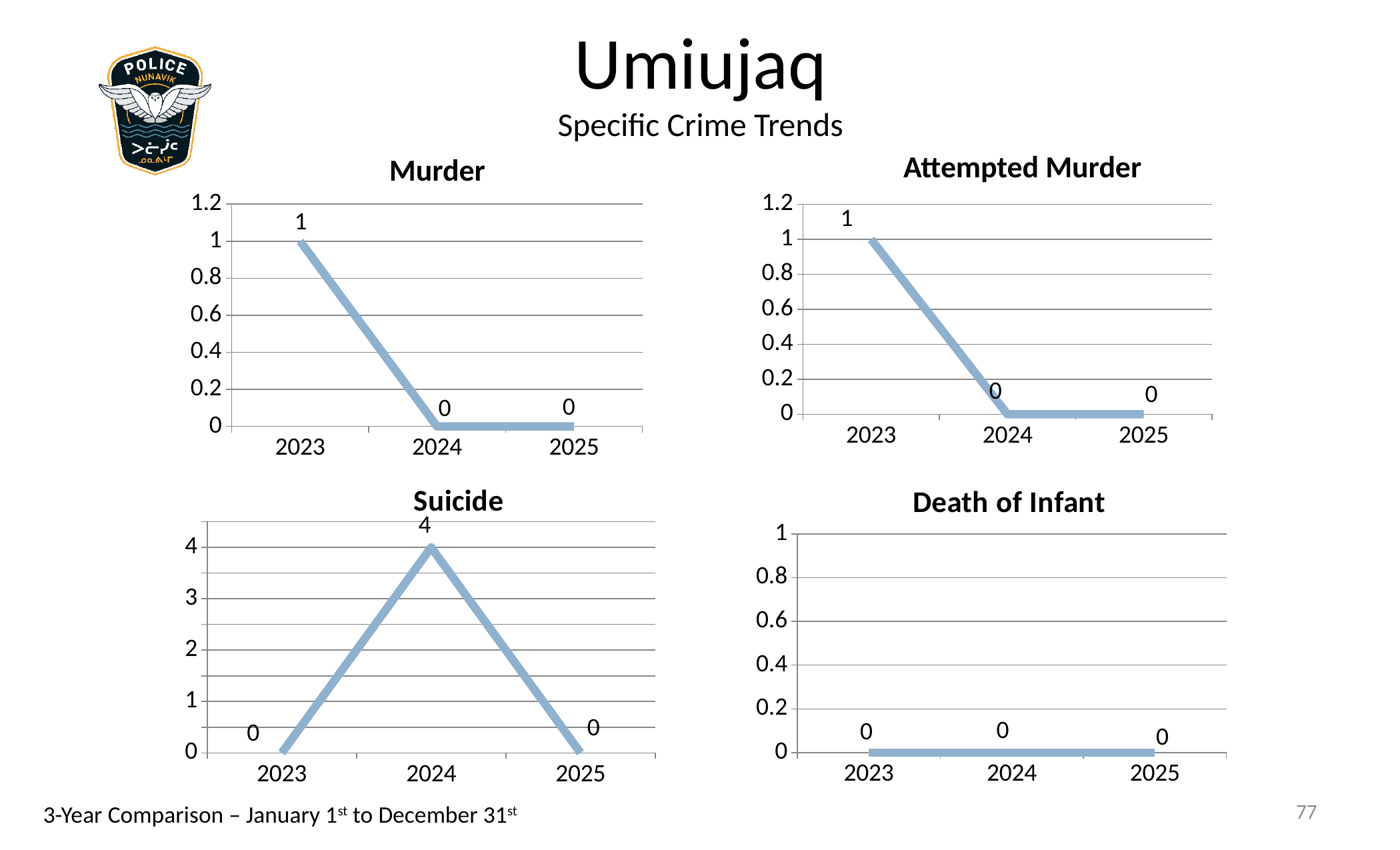
In the Murder chart, do the values rise or fall from 2023 to 2024? fall How many years are plotted in the Attempted Murder chart? 3 In the Death of Infant chart, what is the value for 2025? 0 In the Suicide chart, what is the value for 2024? 4 What kind of chart is the Suicide chart? line chart In the Suicide chart, what is the difference between the 2024 value and the 2023 value? 4 In the Murder chart, what is the value for 2024? 0 In the Attempted Murder chart, what is the value for 2025? 0 In the Murder chart, what is the value for 2023? 1 How many charts are shown on the slide? 4 In the Attempted Murder chart, what is the value for 2023? 1 In the Suicide chart, which year has the highest value? 2024